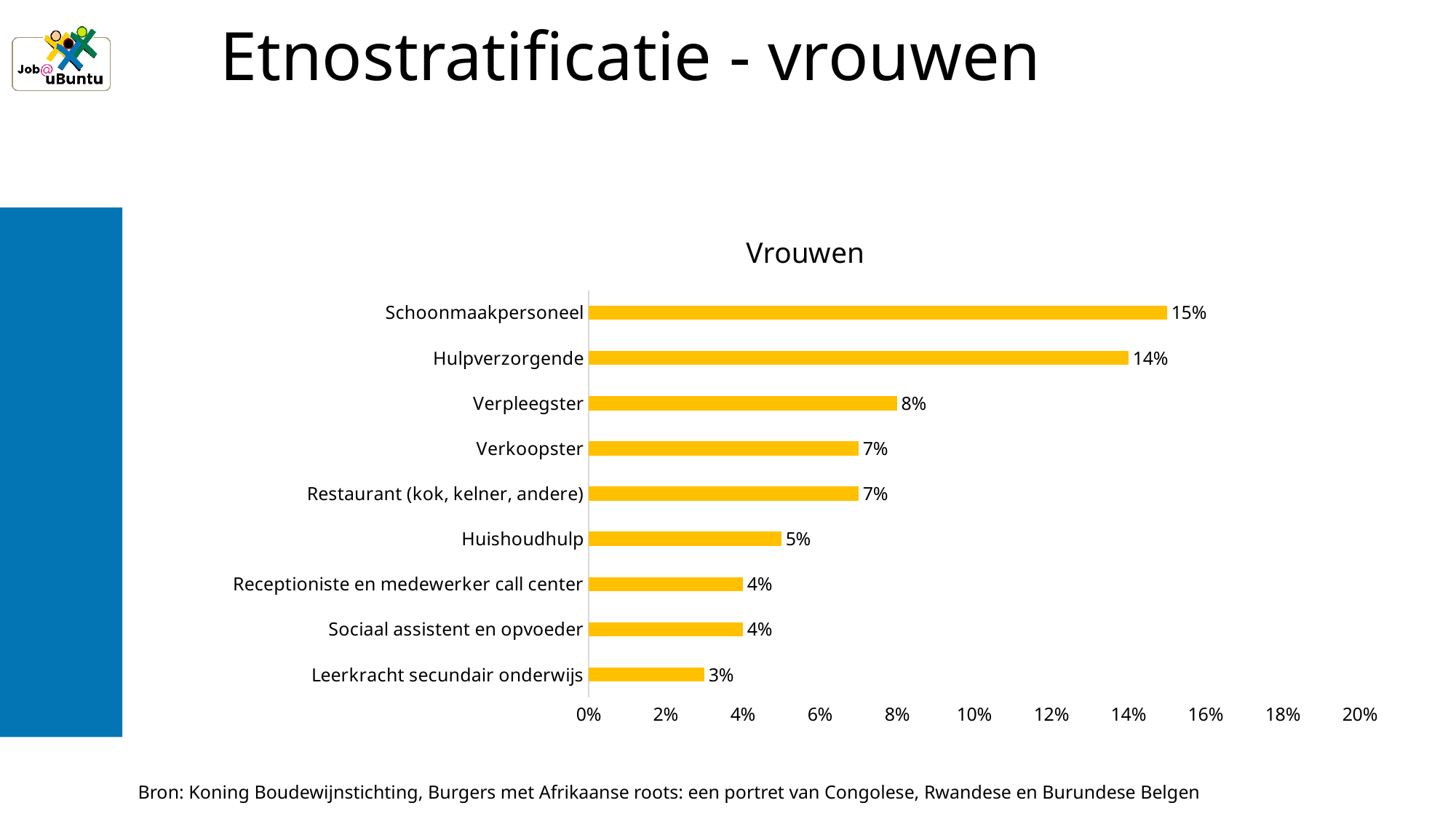
How many categories are shown in the chart? 9 Which is larger, the value for Hulpverzorgende or the value for Verkoopster? Hulpverzorgende What is the value for Huishoudhulp? 5% What is the value for Leerkracht secundair onderwijs? 3% Which category has the lowest value? Leerkracht secundair onderwijs What is the value for Schoonmaakpersoneel? 15% What is the value for Verpleegster? 8% What is the title of the chart? Vrouwen What is the difference between the values for Verpleegster and Huishoudhulp? 3% What kind of chart is shown on the slide? Bar chart Which category has the highest value? Schoonmaakpersoneel What is the difference between the values for Schoonmaakpersoneel and Hulpverzorgende? 1%